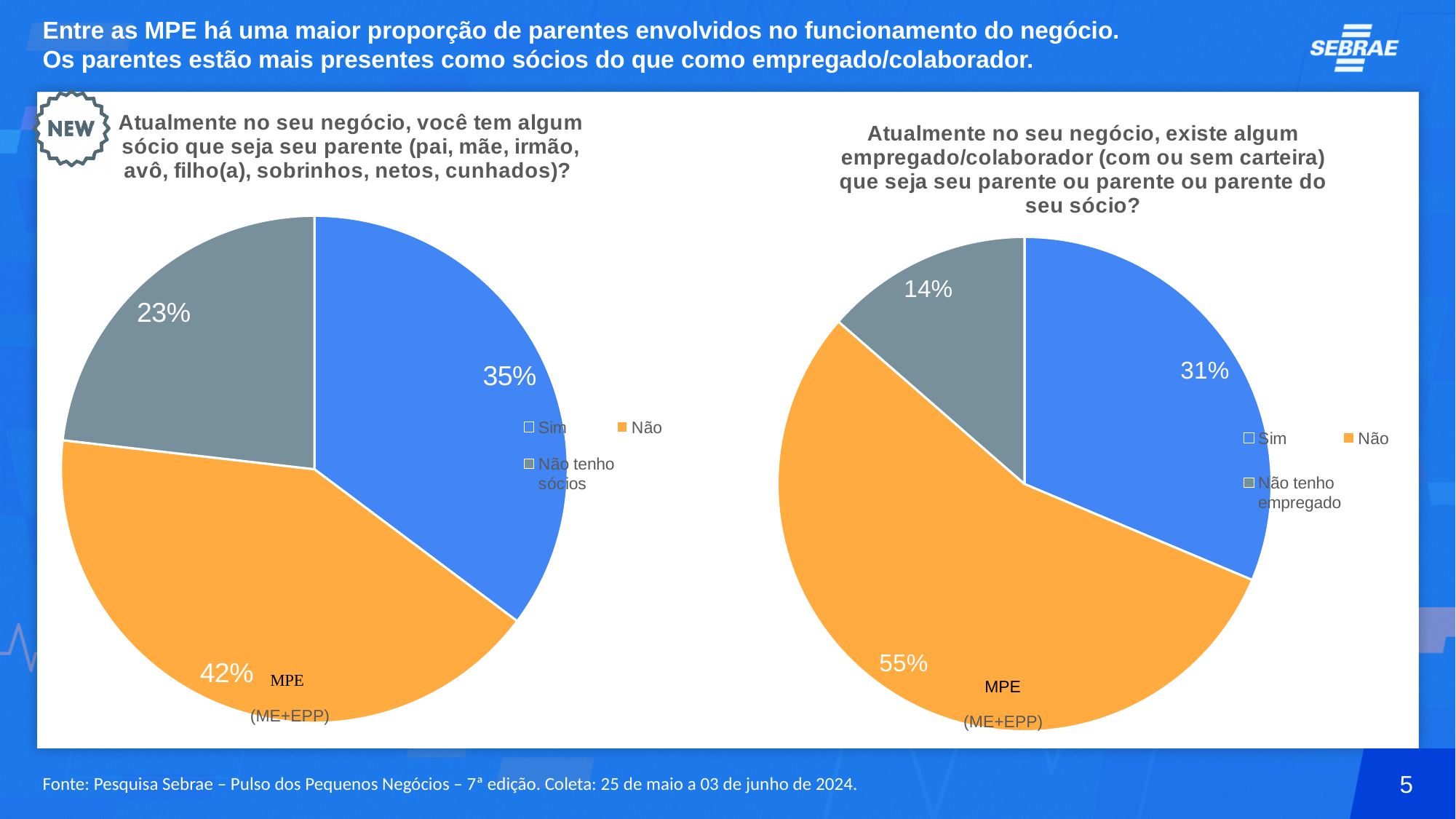
What colour is the "Não" slice in both pie charts? Orange In the left pie chart (about partners who are relatives), what share answered "Sim"? 35% In the right pie chart (about employees who are relatives), what share answered "Não tenho empregado"? 14% In the right pie chart, what is the difference in percentage points between "Não" and "Sim"? 24 In the left pie chart (about partners who are relatives), what share answered "Não tenho sócios"? 23% In the right pie chart, which response has the smallest slice? Não tenho empregado In the left pie chart, what is the difference in percentage points between "Não" and "Sim"? 7 How many slices does the right pie chart have? 3 What type of chart is used on the left side of the slide? Pie chart In the left pie chart, which response has the largest slice? Não Which is larger: the "Sim" share in the left pie chart or the "Sim" share in the right pie chart? Left pie chart (35%) In the right pie chart (about employees who are relatives), what share answered "Não"? 55%